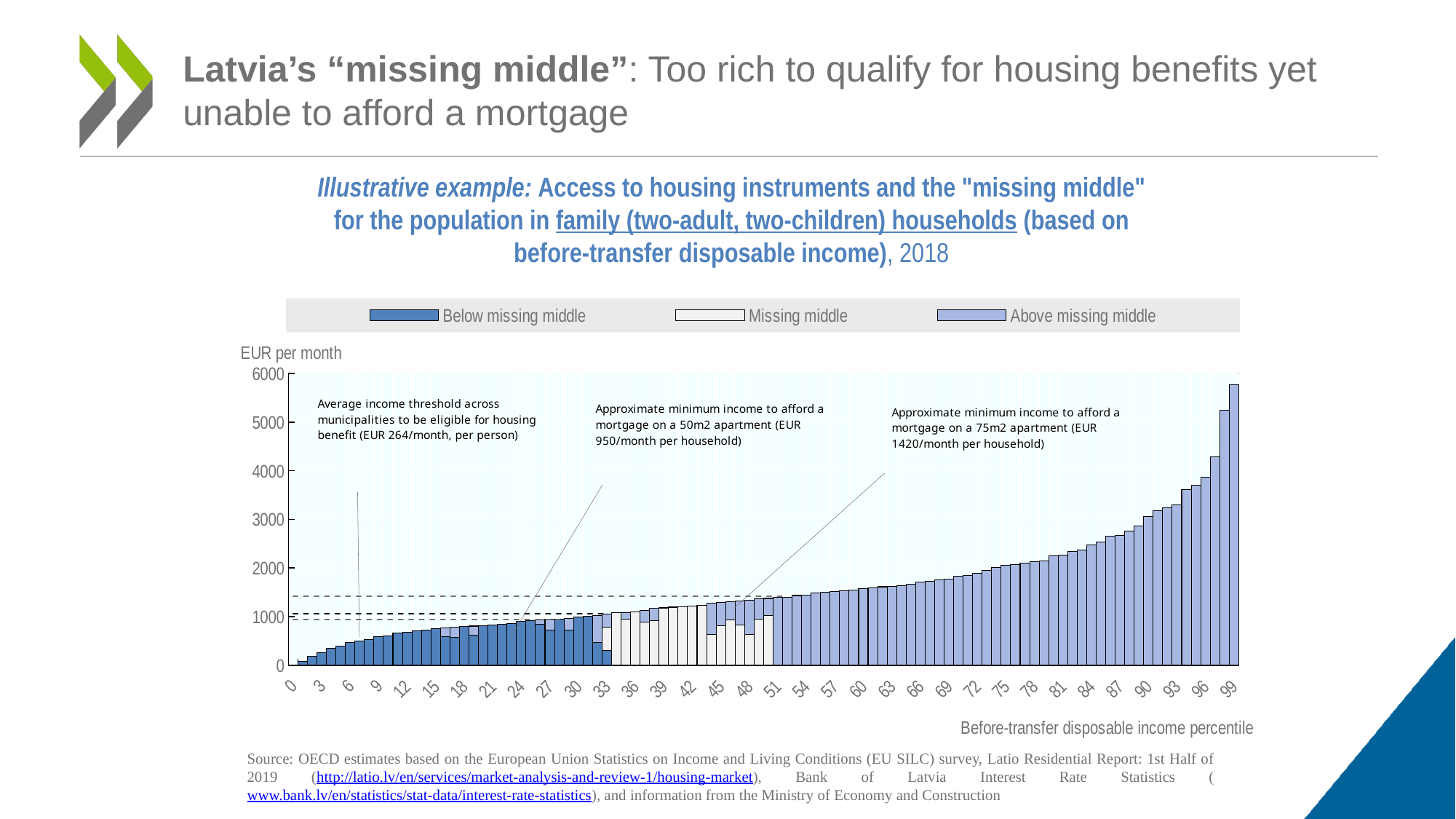
Is the value for percentile 30 greater or less than 2000? less Do the bar values generally rise or fall as the income percentile increases along the x axis? Rise What unit is shown on the y axis of the chart? EUR per month What are the three series named in the legend? Below missing middle, Missing middle, Above missing middle Is the value for percentile 90 greater or less than 2000? greater How many series does the legend list? 3 Which income percentile has the lowest bar? 0 What kind of chart is shown on the slide? Bar chart Which income percentile has the highest bar? 99 Which has the larger value, percentile 96 or percentile 3? 96 Is the value for percentile 0 greater or less than 1000? less